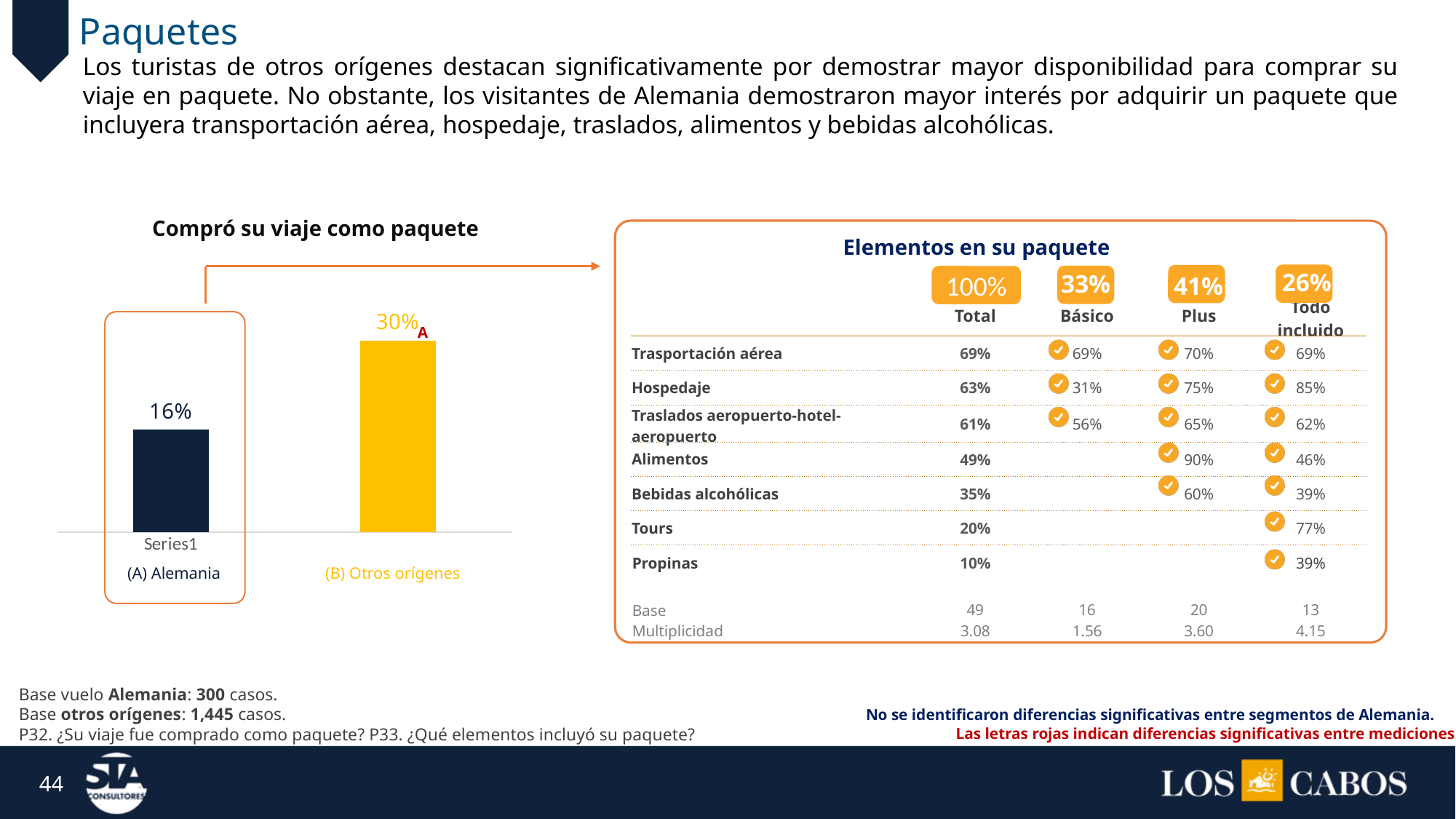
In the chart 'Compró su viaje como paquete', what is the difference between the values for (B) Otros orígenes and (A) Alemania? 14 percentage points How many bars are shown in the chart 'Compró su viaje como paquete'? 2 In the chart 'Compró su viaje como paquete', which is larger: the value for (A) Alemania or for (B) Otros orígenes? (B) Otros orígenes What kind of chart is 'Compró su viaje como paquete'? Bar chart In the chart 'Compró su viaje como paquete', what is the value for (B) Otros orígenes? 30% In the chart 'Compró su viaje como paquete', what colour is the bar for (B) Otros orígenes? Yellow What is the title of the bar chart on the left side of the slide? Compró su viaje como paquete In the chart 'Compró su viaje como paquete', which category has the lowest value? (A) Alemania In the chart 'Compró su viaje como paquete', which category has the highest value? (B) Otros orígenes In the chart 'Compró su viaje como paquete', do the values rise or fall from (A) Alemania to (B) Otros orígenes? Rise In the chart 'Compró su viaje como paquete', what is the value for (A) Alemania? 16%